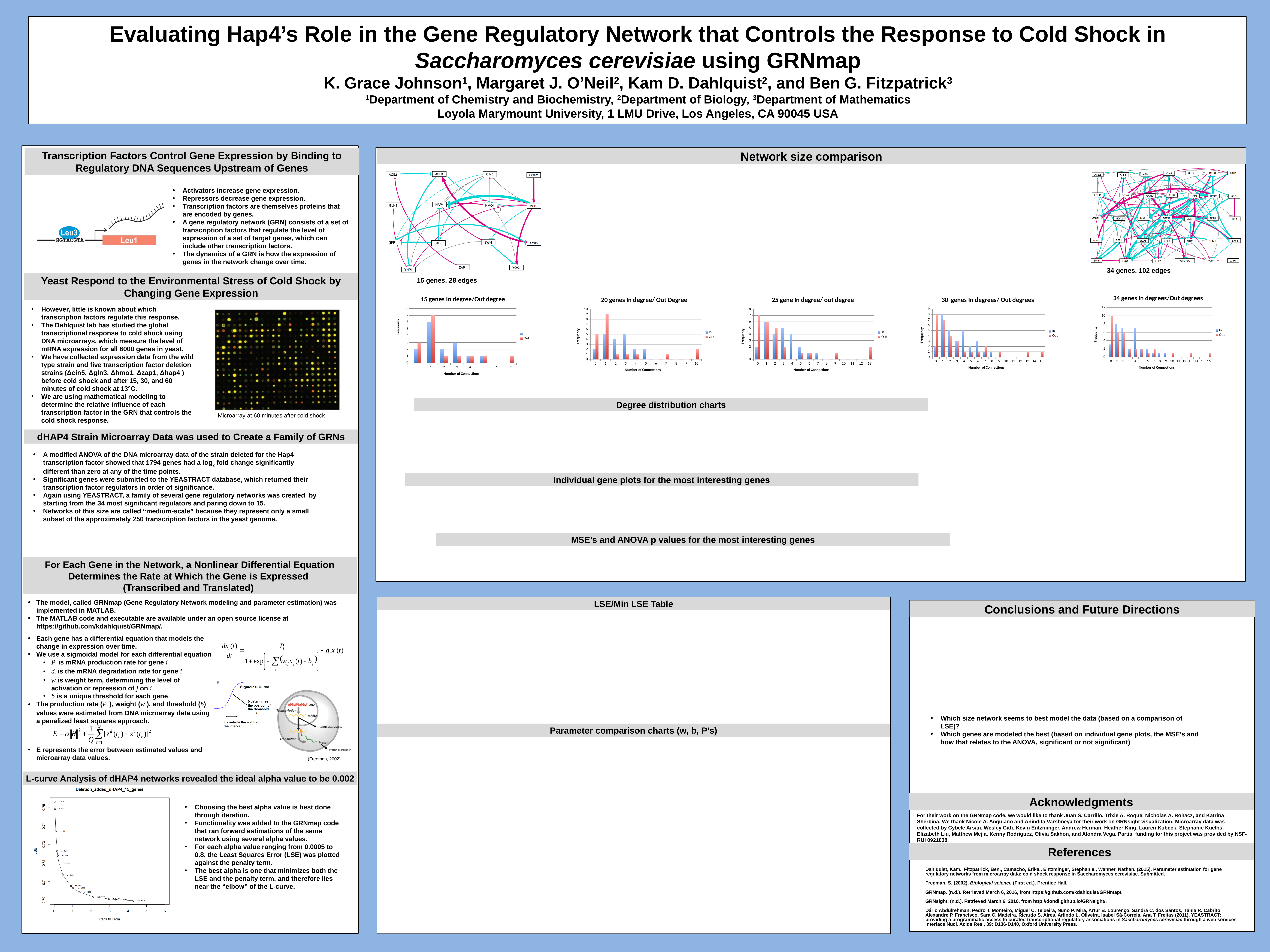
What is the x-axis label of the degree distribution charts? Number of Connections In the "15 genes In degree/Out degree" chart, which is larger at 1 connection, the In frequency or the Out frequency? Out In the "20 genes In degree/ Out Degree" chart, which number of connections has the highest Out frequency? 1 In the "34 genes In degrees/Out degrees" chart, which number of connections has the highest Out frequency? 0 In the L-curve chart titled "Deletion_added_dHAP4_15_genes", does LSE rise or fall as the Penalty Term increases? fall How many series does the legend of the "20 genes In degree/ Out Degree" chart list? 2 In the "20 genes In degree/ Out Degree" chart, is the Out frequency at 1 connection greater or less than 5? greater In the "15 genes In degree/Out degree" chart, is the In frequency at 1 connection greater or less than 4? greater In the "15 genes In degree/Out degree" chart, which number of connections has the highest Out frequency? 1 What kind of chart is the "15 genes In degree/Out degree" chart? bar chart What are the two legend entries in the "34 genes In degrees/Out degrees" chart? In, Out